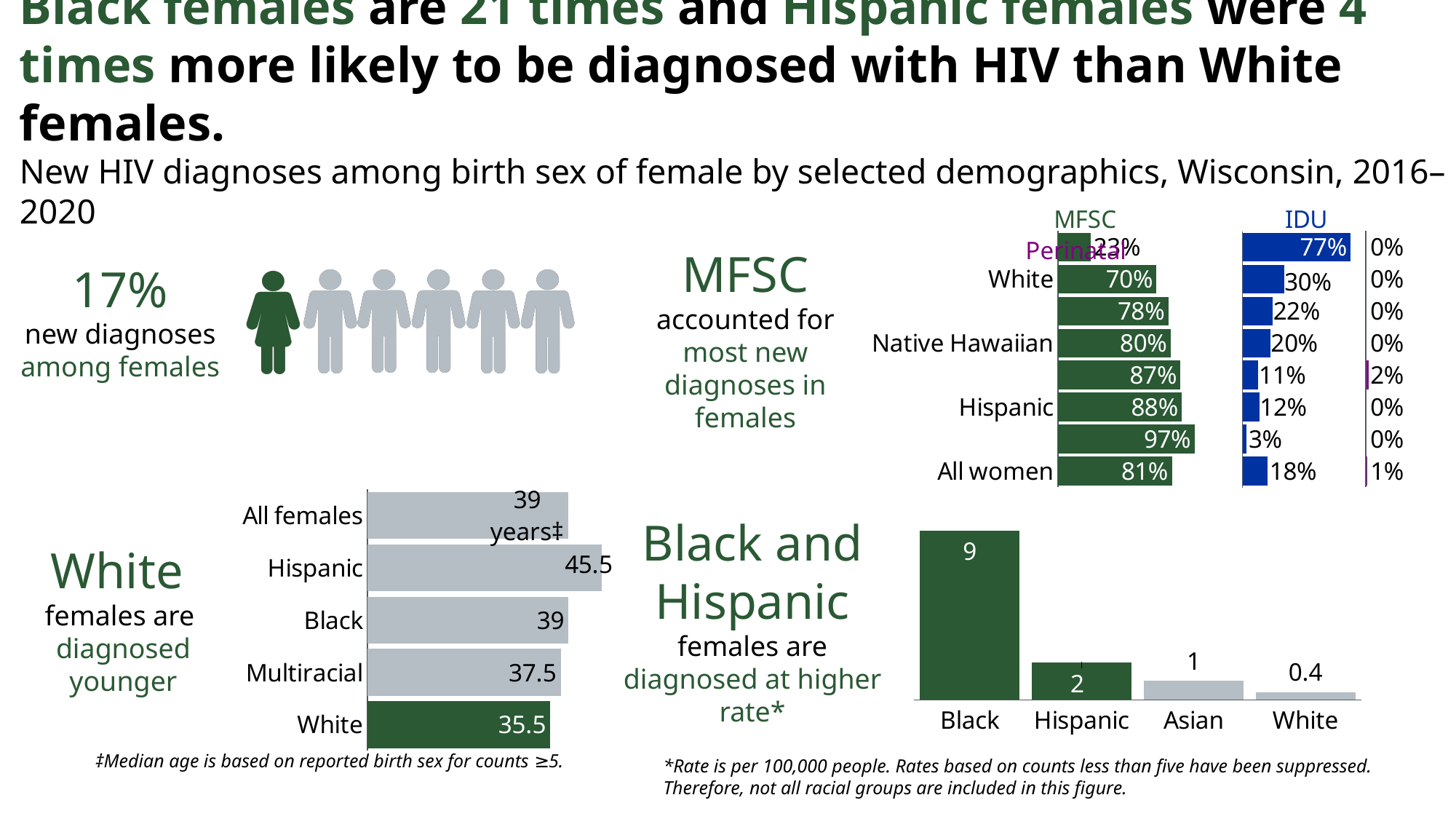
In the median age bar chart at the bottom left, which group has the lowest median age? White In the MFSC/IDU chart at the top right, what is the IDU percentage for White females? 30% In the diagnosis rate bar chart at the bottom right, which group has the lowest rate? White In the median age bar chart at the bottom left, which group has the highest median age? Hispanic In the median age bar chart at the bottom left, how many groups are shown? 5 In the diagnosis rate bar chart at the bottom right, what is the rate for White females? 0.4 In the median age bar chart at the bottom left, what is the difference between the median age for Hispanic females and White females? 10 In the MFSC/IDU chart at the top right, what is the MFSC percentage for Hispanic females? 88% In the median age bar chart at the bottom left, what is the median age for Hispanic females? 45.5 In the diagnosis rate bar chart at the bottom right, what is the rate for Black females? 9 In the diagnosis rate bar chart at the bottom right, what is the difference between the rates for Black and Hispanic females? 7 In the median age bar chart at the bottom left, what is the median age for White females? 35.5